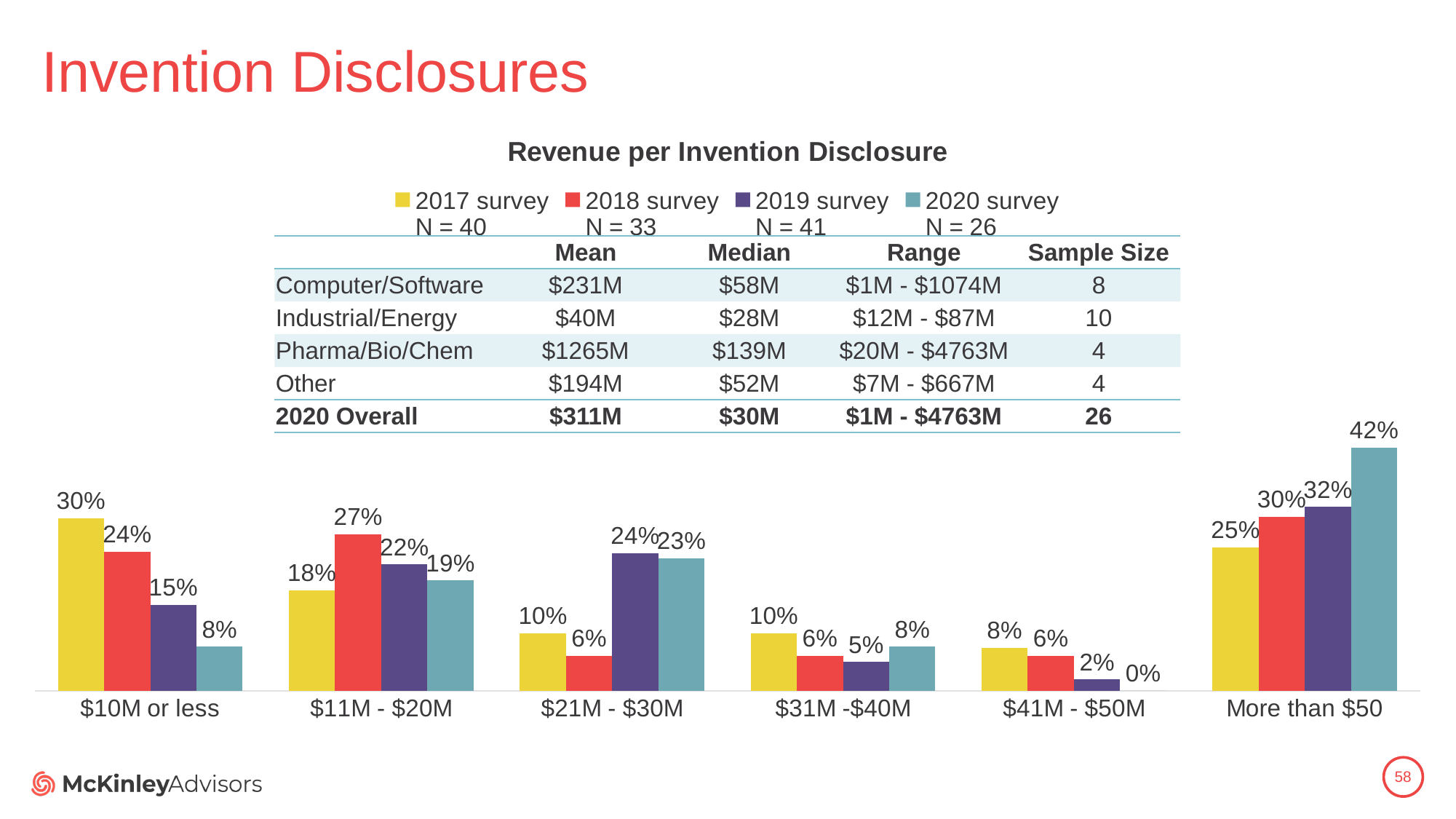
What is the value for the 2017 survey in the '$10M or less' category? 30% Which category has the highest value for the 2020 survey? More than $50 What is the title of the chart? Revenue per Invention Disclosure How many revenue categories are shown on the x axis of the chart? 6 Which category has the lowest value for the 2019 survey? $41M - $50M What is the value for the 2018 survey in the '$41M - $50M' category? 6% Which is larger in the '$11M - $20M' category: the 2018 survey value or the 2019 survey value? 2018 survey What kind of chart is shown on the slide? Bar chart How many series does the chart legend list? 4 What is the value for the 2020 survey in the 'More than $50' category? 42% What is the difference between the 2017 survey and 2020 survey values in the '$10M or less' category? 22% What is the value for the 2019 survey in the '$21M - $30M' category? 24%